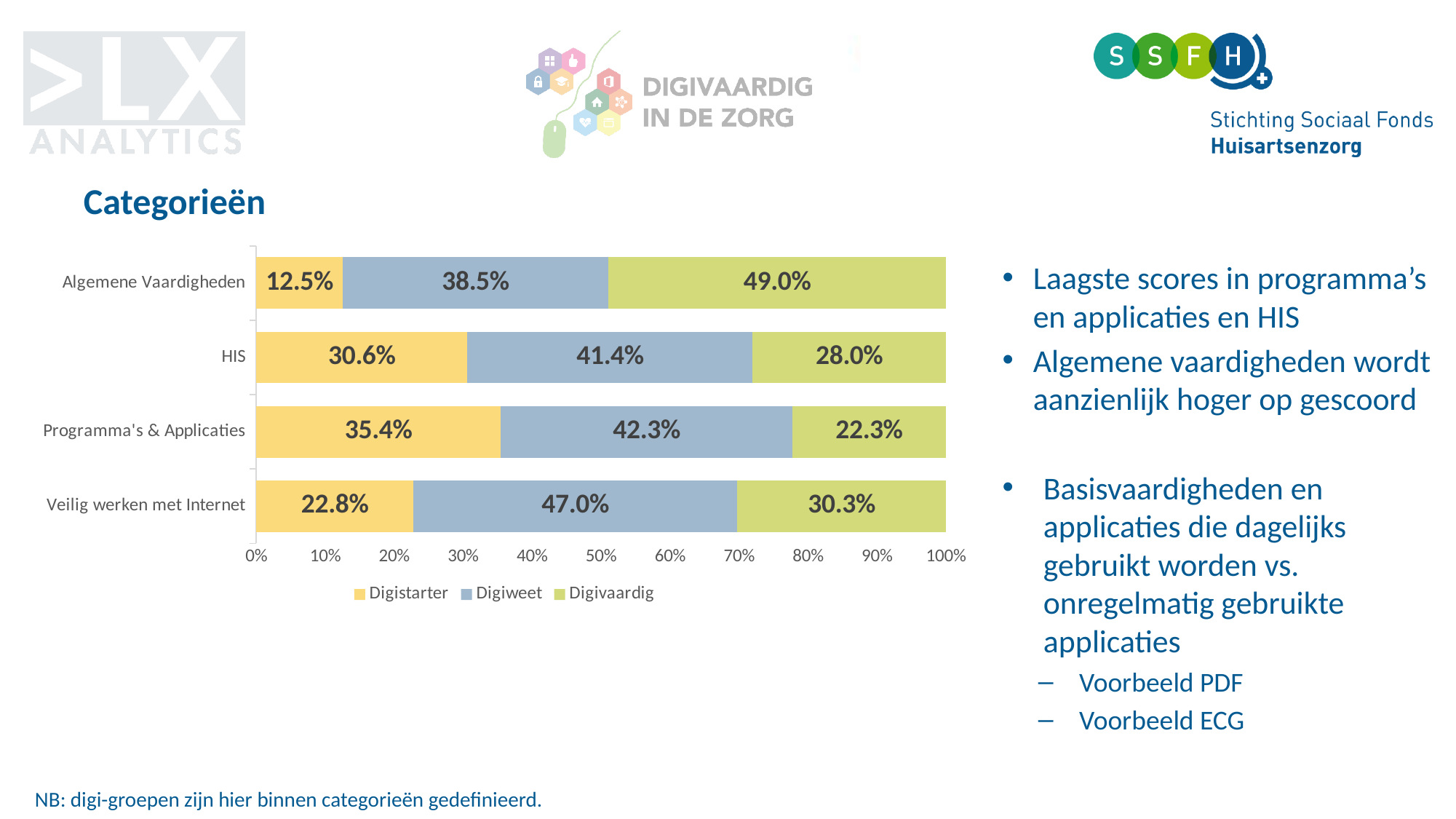
What is the Digiweet value for Veilig werken met Internet? 47.0% Which series is shown in yellow in the legend? Digistarter What is the difference between the Digivaardig values for Algemene Vaardigheden and HIS? 21.0% How many categories are shown on the chart? 4 What is the Digistarter value for HIS? 30.6% Which is larger: the Digiweet value for HIS or the Digiweet value for Programma's & Applicaties? Programma's & Applicaties What is the Digivaardig value for Algemene Vaardigheden? 49.0% What kind of chart is shown on the slide? Stacked bar chart How many series does the legend list? 3 Which category has the lowest Digivaardig value? Programma's & Applicaties What is the total of the stacked bar for Veilig werken met Internet? 100.1% Which category has the highest Digistarter value? Programma's & Applicaties